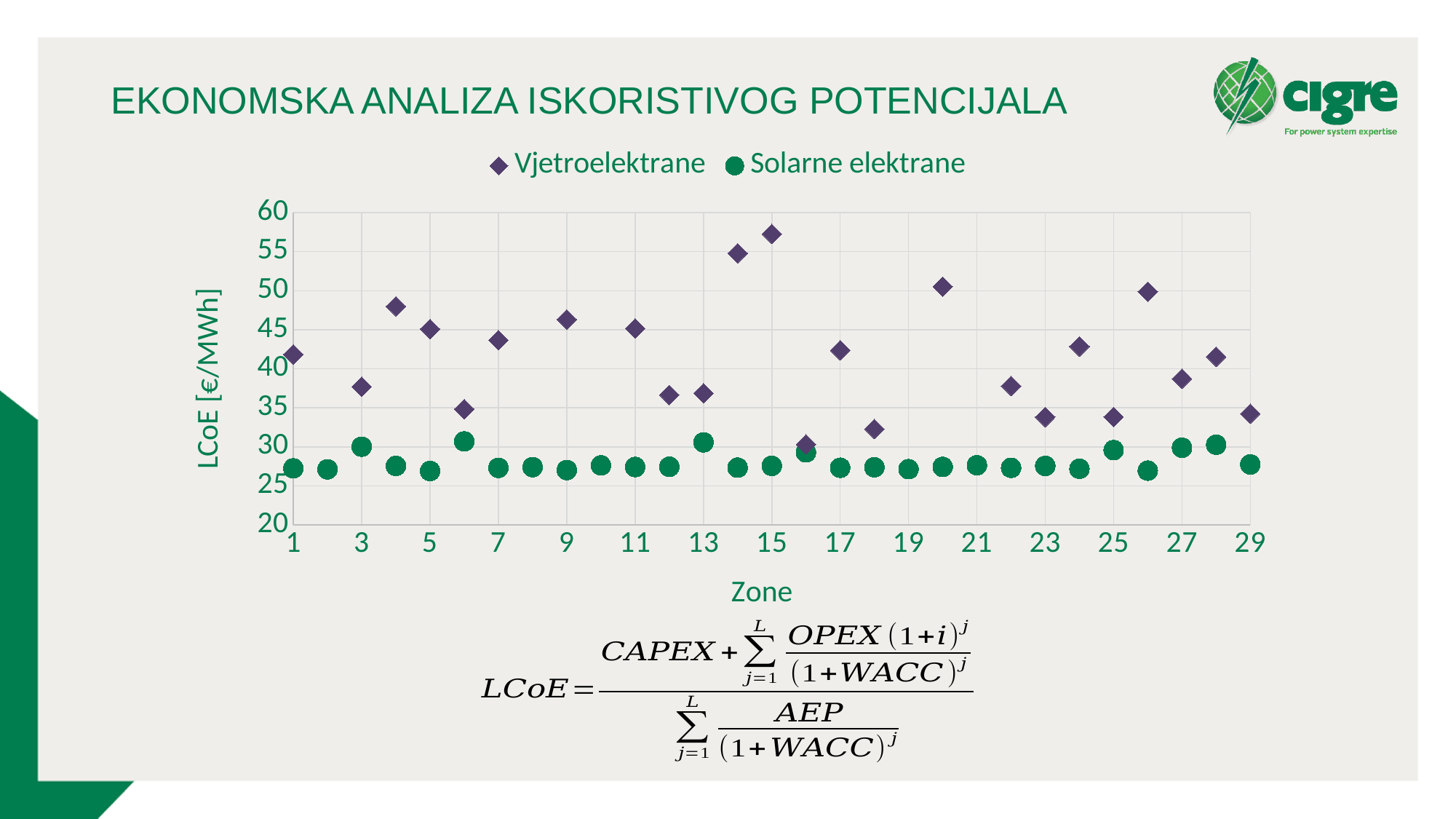
Which is larger, the Vjetroelektrane value for zone 3 or for zone 4? Zone 4 Is the Solarne elektrane value for zone 1 greater or less than 30? less Is the Vjetroelektrane value for zone 15 greater or less than 55? greater For which zone is the Vjetroelektrane value lowest? 16 Is the Vjetroelektrane value for zone 14 greater or less than 50? greater What kind of chart is shown on the slide? Scatter chart For which zone is the Vjetroelektrane value highest? 15 How many zones are shown along the x axis? 29 What is the label of the vertical axis? LCoE [€/MWh] How many series does the chart legend list? 2 What are the two series named in the legend? Vjetroelektrane and Solarne elektrane